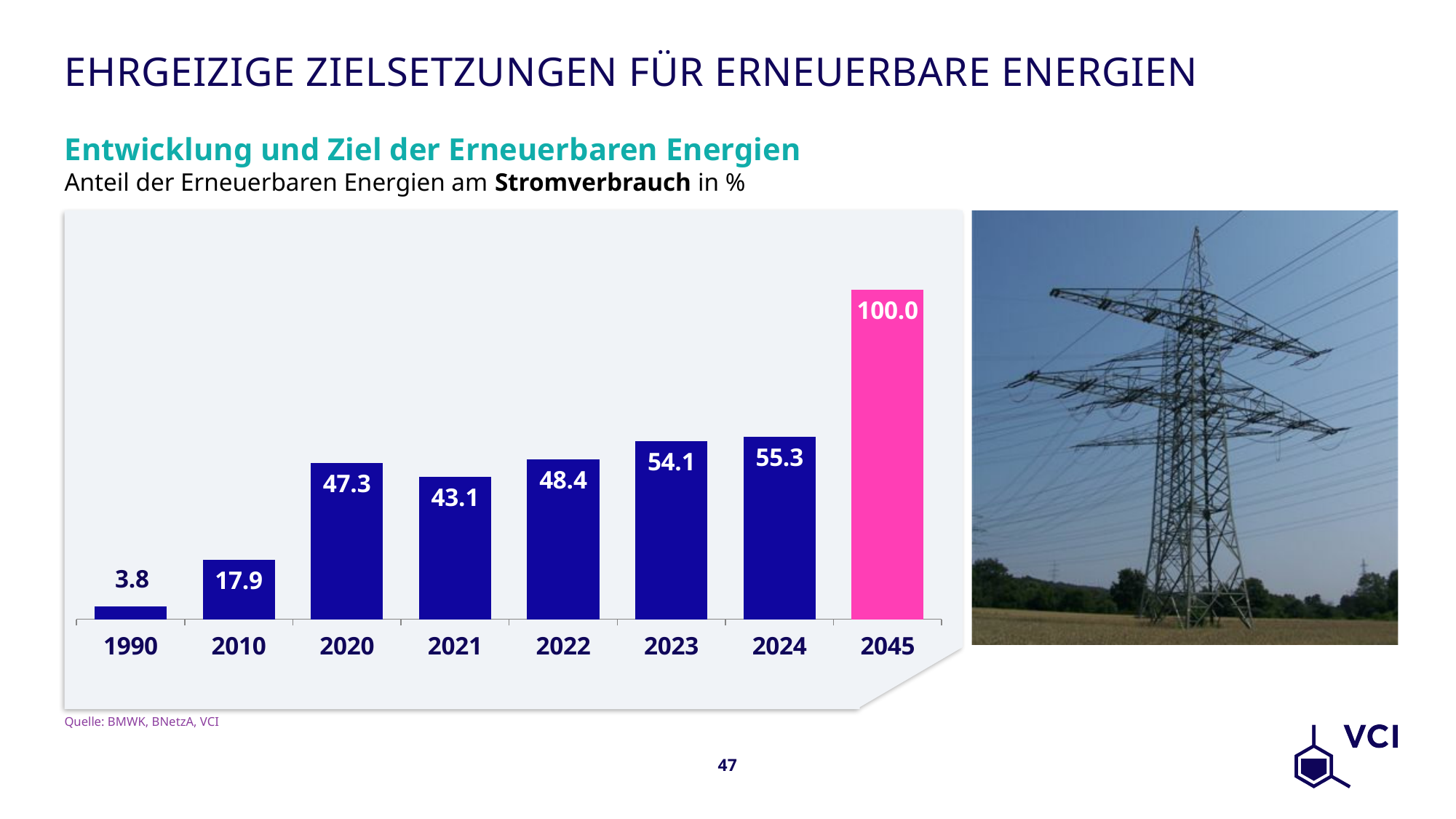
Which year has the highest value? 2045 What is the difference between the values for 2020 and 2021? 4.2 How many years are shown on the x axis? 8 What is the target value shown for 2045? 100.0 What is the difference between the values for 2024 and 2023? 1.2 What kind of chart is shown? bar chart What is the value for 1990? 3.8 Which bar is shown in a different colour (pink) from the others? 2045 Which is larger, the value for 2020 or the value for 2021? 2020 What is the value for 2024? 55.3 Which year has the lowest value? 1990 What is the value for 2020? 47.3